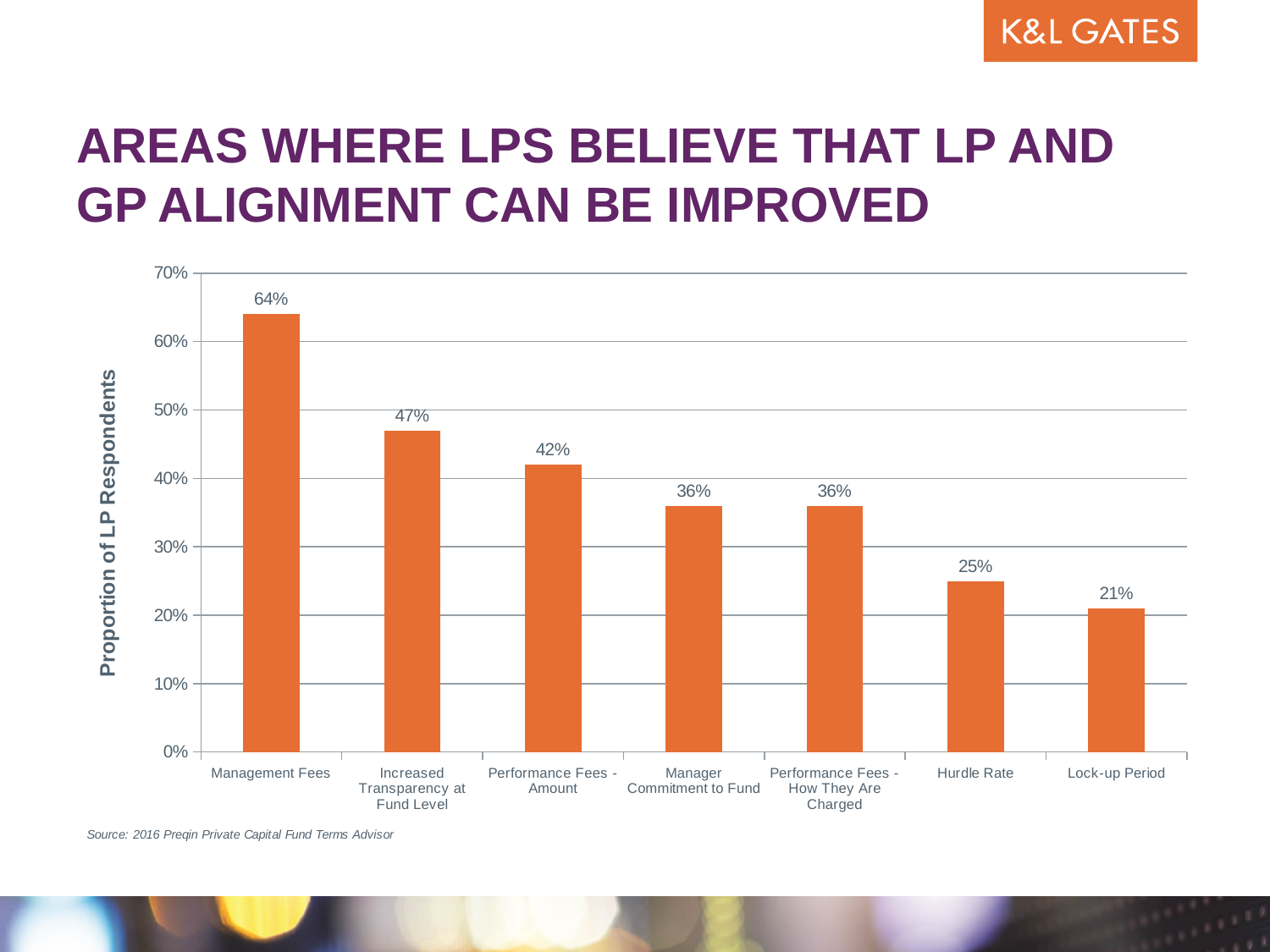
How many categories are shown on the chart? 7 What is the difference between the values for Management Fees and Lock-up Period? 43% Which category has the highest proportion of LP respondents? Management Fees What is the value for Hurdle Rate? 25% What is the label of the vertical axis? Proportion of LP Respondents What is the value for Increased Transparency at Fund Level? 47% Is the value for Manager Commitment to Fund greater or less than 40%? less What is the difference between the values for Performance Fees - Amount and Hurdle Rate? 17% Which is larger, the value for Increased Transparency at Fund Level or the value for Performance Fees - Amount? Increased Transparency at Fund Level Which category has the lowest proportion of LP respondents? Lock-up Period What proportion of LP respondents selected Management Fees? 64% What kind of chart is shown on the slide? Bar chart